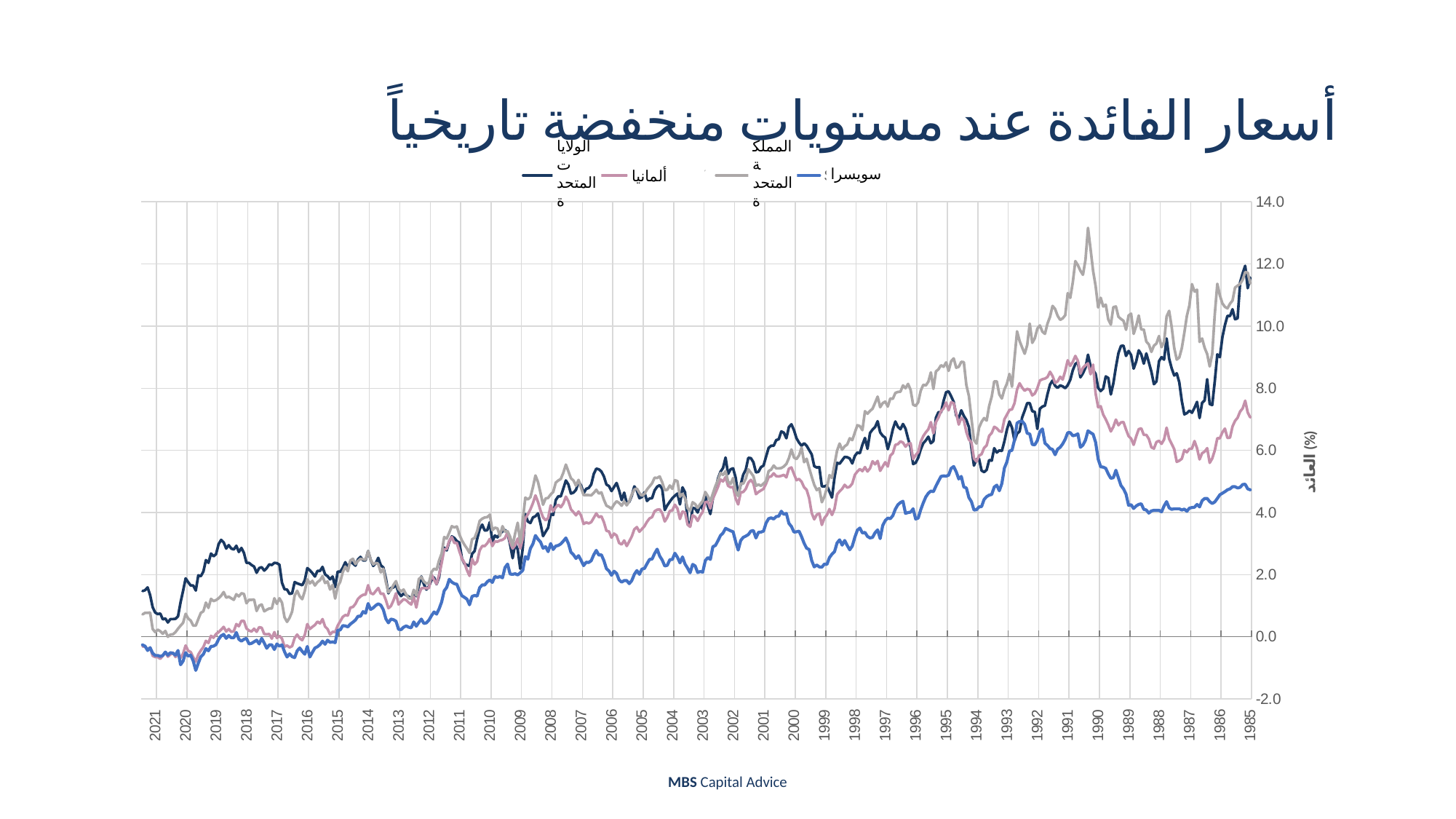
What is the title of the chart? أسعار الفائدة عند مستويات منخفضة تاريخياً Is the peak value for المملكة المتحدة around 1990 greater or less than 12.0? greater What is the label of the vertical axis? العائد (%) How many series does the legend list? 4 Is the value for سويسرا in 1985 greater or less than 4.0? greater In 2021, which is higher, الولايات المتحدة or سويسرا? الولايات المتحدة Is the value for الولايات المتحدة in 1985 greater or less than 10.0? greater Around 1990, which is higher, المملكة المتحدة or سويسرا? المملكة المتحدة Which series reaches the highest value anywhere on the chart? المملكة المتحدة Over time from 1985 to 2021, do the interest rates generally rise or fall? fall What kind of chart is shown on the slide? line chart